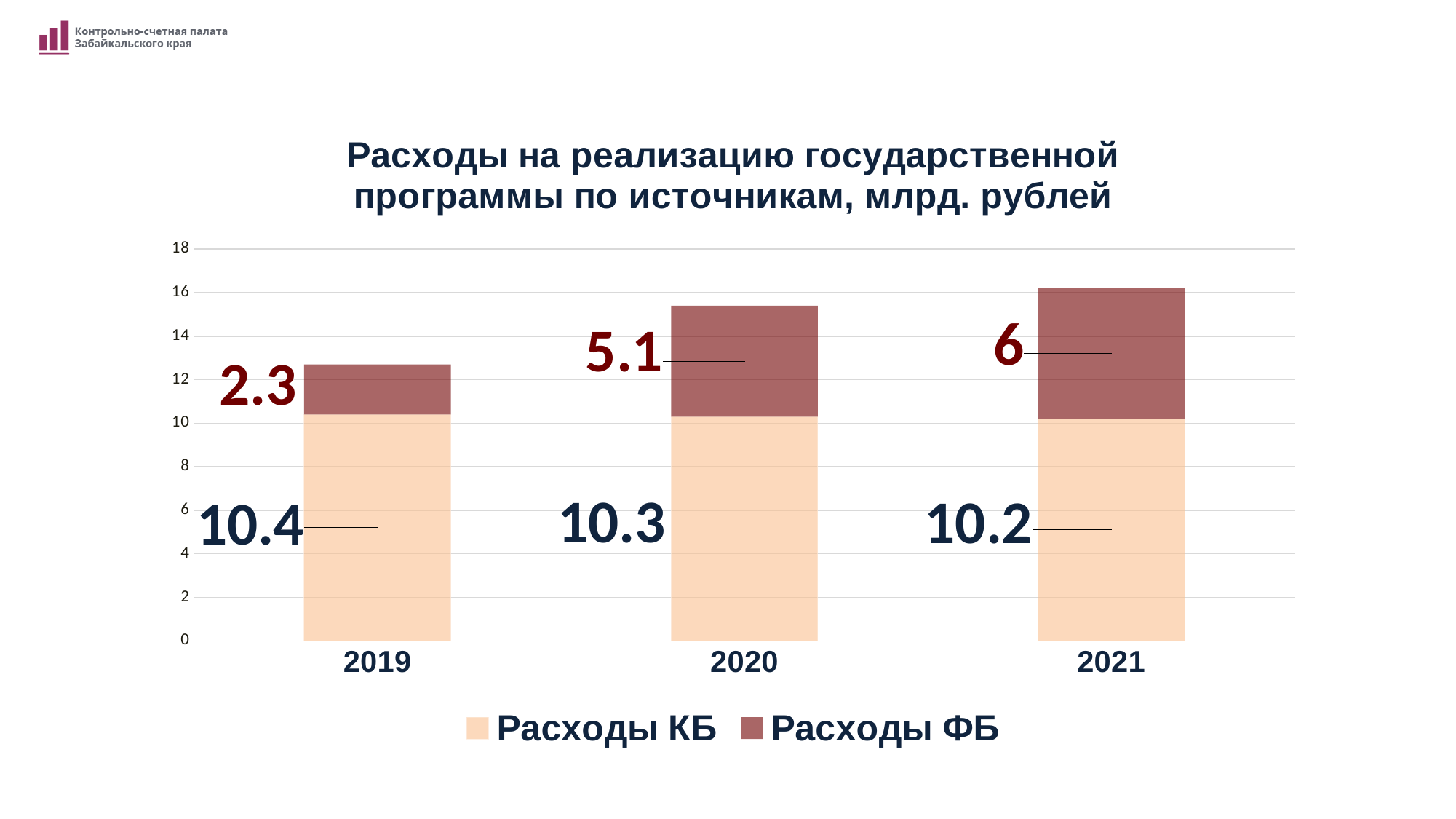
What is the value of Расходы ФБ for 2020? 5.1 In which year is Расходы ФБ the lowest? 2019 What is the total of the stacked bar for 2020? 15.4 What is the difference between Расходы ФБ in 2021 and in 2019? 3.7 What is the total of the stacked bar for 2021? 16.2 What is the value of Расходы ФБ for 2021? 6 In which year is Расходы ФБ the highest? 2021 How many years are shown on the x axis? 3 What kind of chart is shown on the slide? Stacked bar chart How many series does the legend list? 2 What is the value of Расходы КБ for 2019? 10.4 Which is larger: Расходы КБ in 2019 or Расходы КБ in 2021? Расходы КБ in 2019